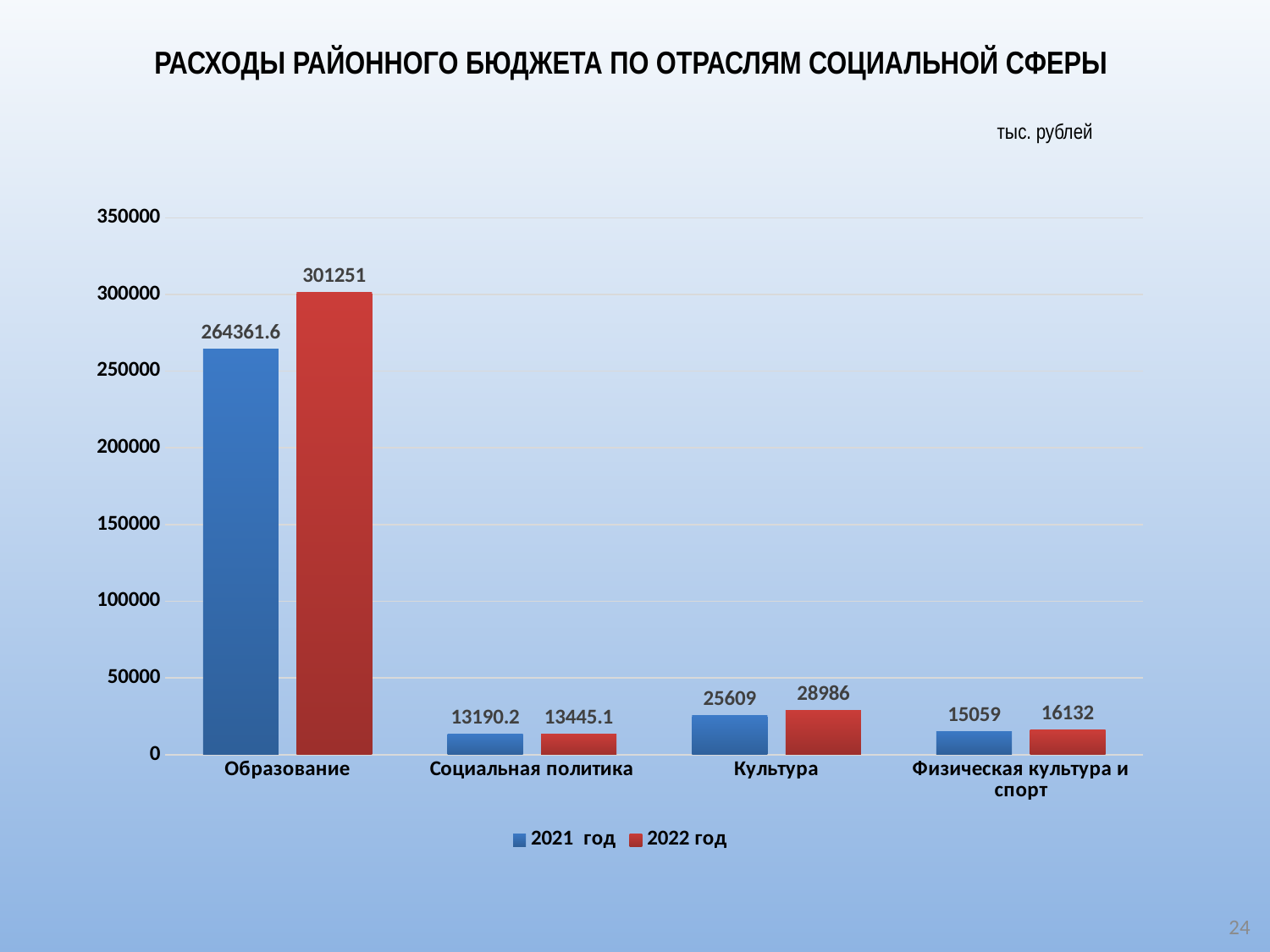
How many series does the legend list? 2 What is the value for Культура in the 2022 год series? 28986 What is the value for Физическая культура и спорт in the 2022 год series? 16132 What kind of chart is shown on the slide? Bar chart What is the difference between the 2022 год and 2021 год values for Образование? 36889.4 Which category has the lowest value in the 2021 год series? Социальная политика What is the value for Образование in the 2021 год series? 264361.6 What is the difference between the 2022 год and 2021 год values for Культура? 3377 How many categories are shown on the x axis? 4 What is the value for Социальная политика in the 2021 год series? 13190.2 Which is larger: the 2021 год value for Культура or the 2021 год value for Физическая культура и спорт? Культура Which category has the highest value in the 2022 год series? Образование